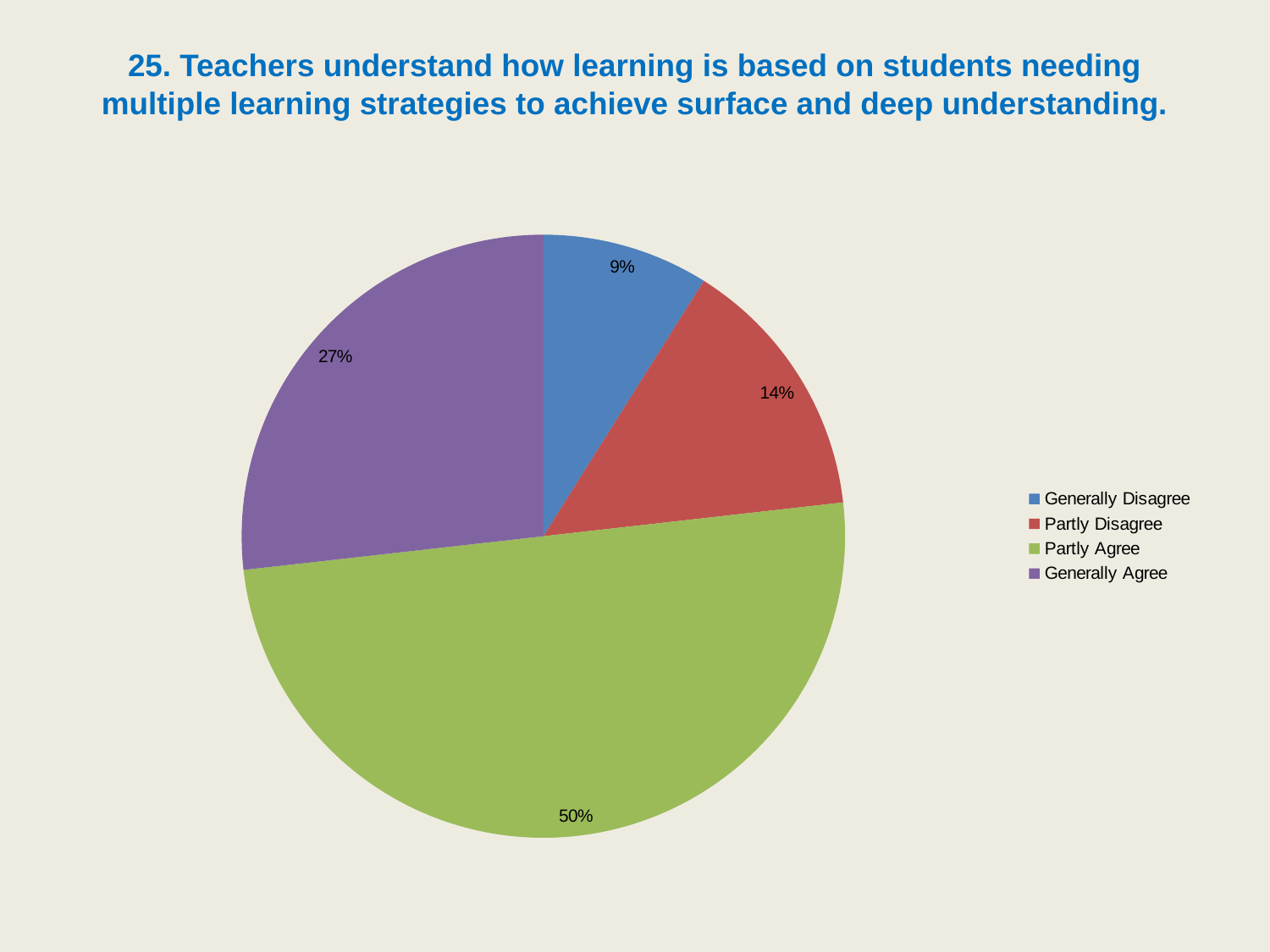
Which response category has the largest share of the pie? Partly Agree What is the difference in percentage points between Partly Agree and Generally Agree? 23 What percentage of respondents chose Partly Agree? 50% How many categories does the pie chart have? 4 Which colour represents Partly Agree in the legend? green Which is larger, the share for Partly Disagree or the share for Generally Agree? Generally Agree What percentage of respondents chose Generally Agree? 27% Which response category has the smallest share of the pie? Generally Disagree What kind of chart is shown on the slide? pie chart What percentage of respondents chose Partly Disagree? 14% What is the combined share of Generally Disagree and Partly Disagree? 23% What percentage of respondents chose Generally Disagree? 9%